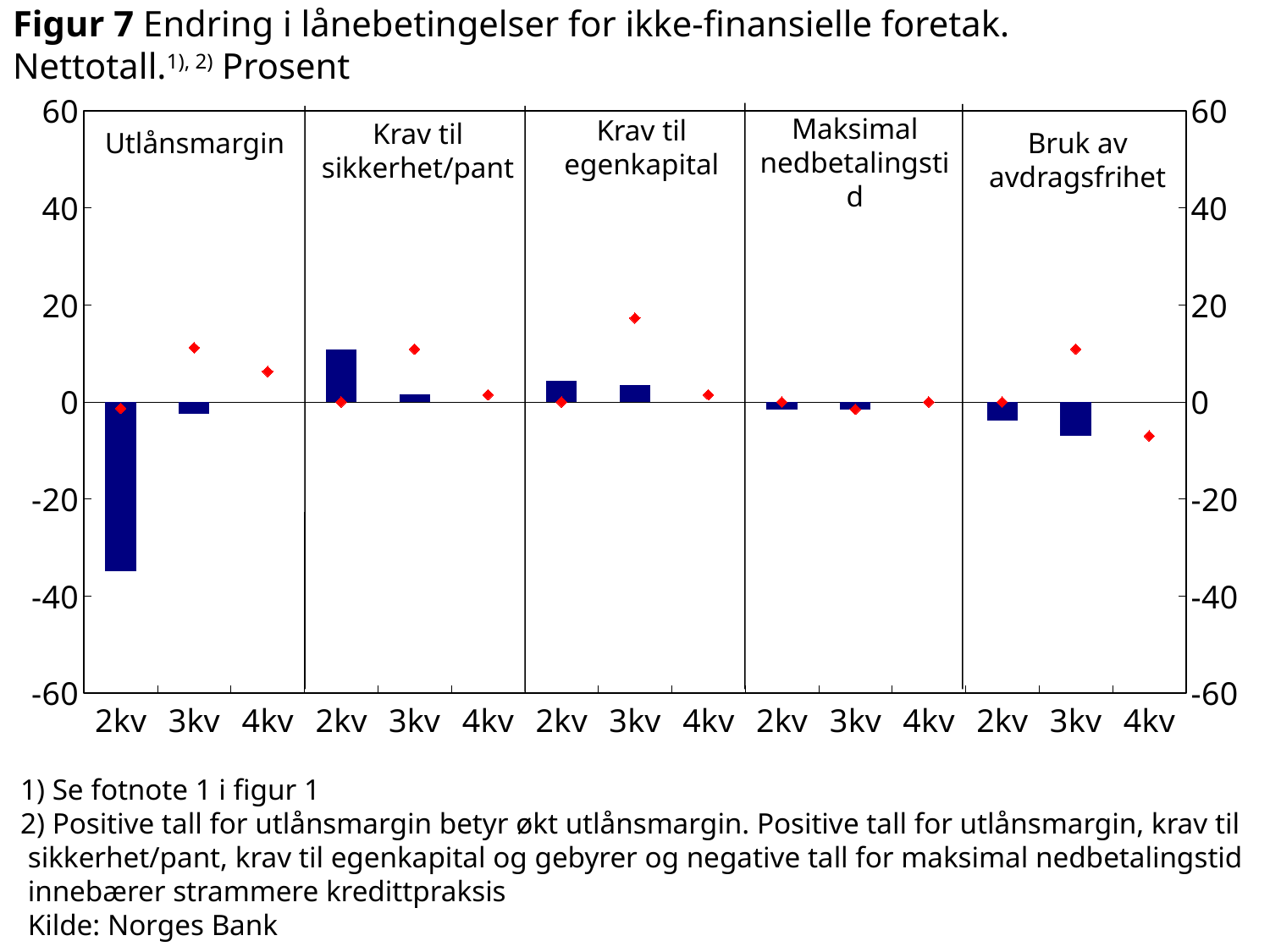
What is the maximum value shown on the vertical axis? 60 Which panel and quarter has the highest bar value in the chart? Krav til sikkerhet/pant, 2kv Which panel and quarter has the lowest bar value in the chart? Utlånsmargin, 2kv Is the bar value for Utlånsmargin in 2kv greater or less than -20? less Is the red diamond value for Krav til egenkapital in 3kv greater or less than 20? less In the Krav til sikkerhet/pant panel, do the bar values rise or fall from 2kv to 4kv? fall Which panel and quarter has the highest red diamond value in the chart? Krav til egenkapital, 3kv In the Utlånsmargin panel, which bar is larger: 2kv or 3kv? 3kv Is the bar value for Krav til sikkerhet/pant in 2kv greater or less than 0? greater What kind of chart is shown on the slide? bar chart How many quarters are shown on the x axis within each panel? 3 How many loan-condition panels (categories) does the chart show? 5